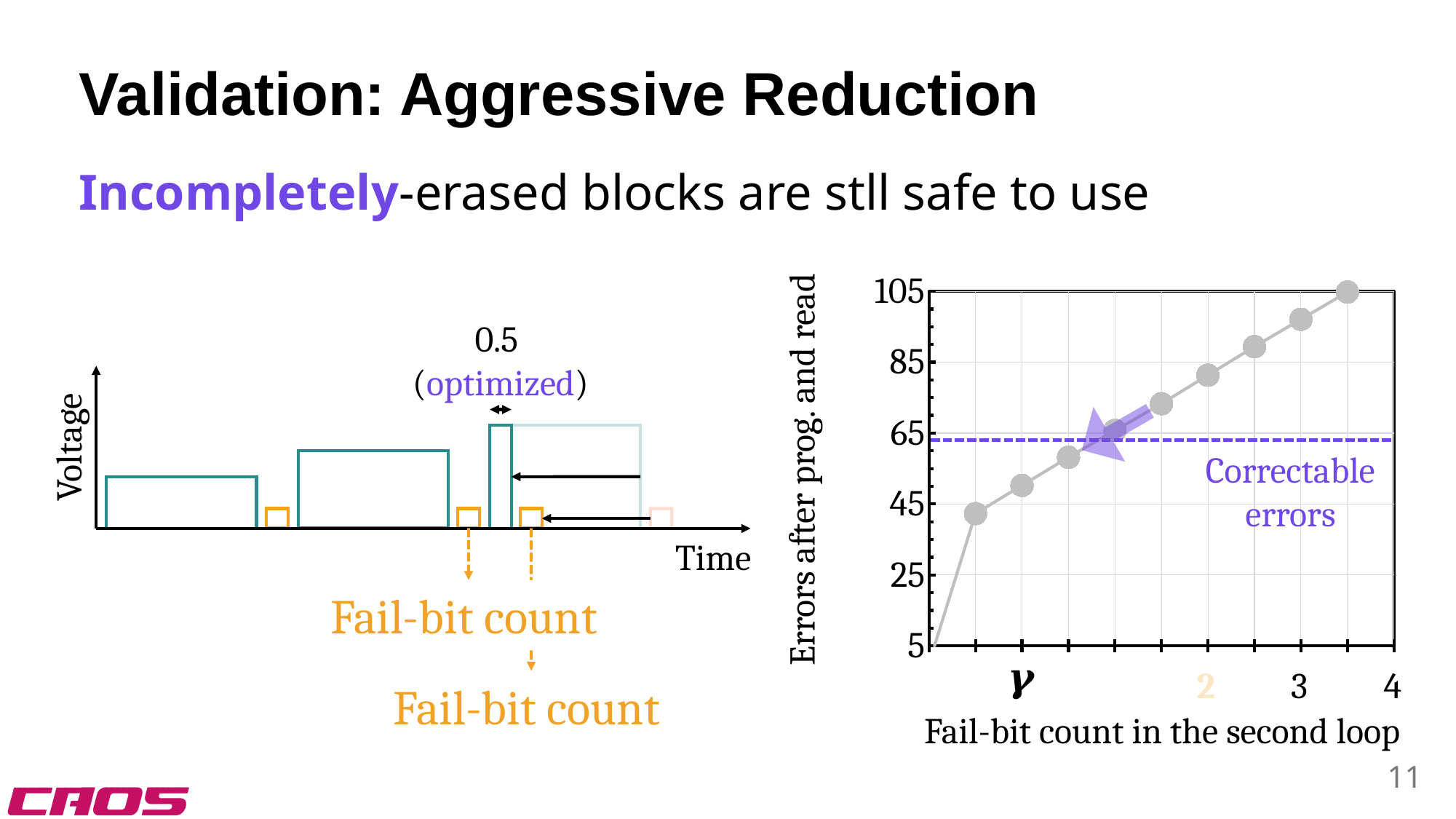
In the chart on the right, is the value of the lowest plotted dot greater or less than 65? less In the chart on the right, is the value at fail-bit count 2 greater or less than 65? greater What kind of chart is shown on the right of the slide? line chart In the chart on the right, is the value at fail-bit count 3 greater or less than 65? greater In the chart on the right, which plotted point has the highest errors: the leftmost or the rightmost? the rightmost What is the highest tick value shown on the y-axis of the chart on the right? 105 What label is given to the dashed horizontal line in the chart on the right? Correctable errors What is the y-axis title of the chart on the right? Errors after prog. and read In the chart on the right, do the errors after prog. and read rise or fall as the fail-bit count in the second loop increases? rise How many data points are plotted as dots in the chart on the right? 9